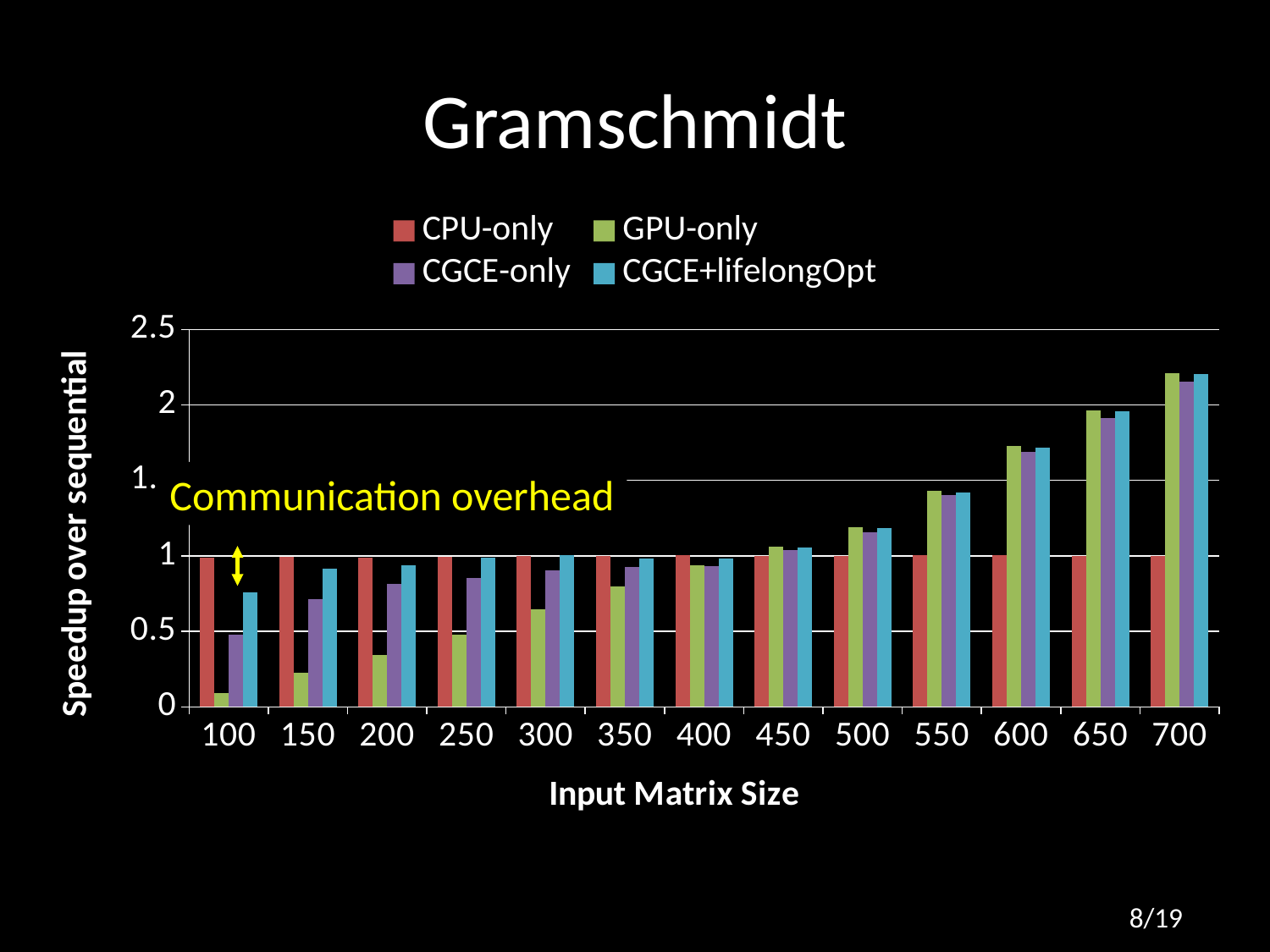
How many series does the legend list? 4 At input matrix size 100, which is larger: the GPU-only value or the CGCE+lifelongOpt value? CGCE+lifelongOpt What is the title of the chart? Gramschmidt Is the CGCE+lifelongOpt value at input matrix size 700 greater or less than 2? greater What kind of chart is shown on the slide? bar chart Do the GPU-only values rise or fall as the input matrix size increases? rise Is the CGCE+lifelongOpt value at input matrix size 100 greater or less than 1? less Is the GPU-only value at input matrix size 200 greater or less than 0.5? less How many input matrix sizes are shown on the x axis? 13 At which input matrix size is the GPU-only speedup highest? 700 What is the label of the y axis? Speedup over sequential